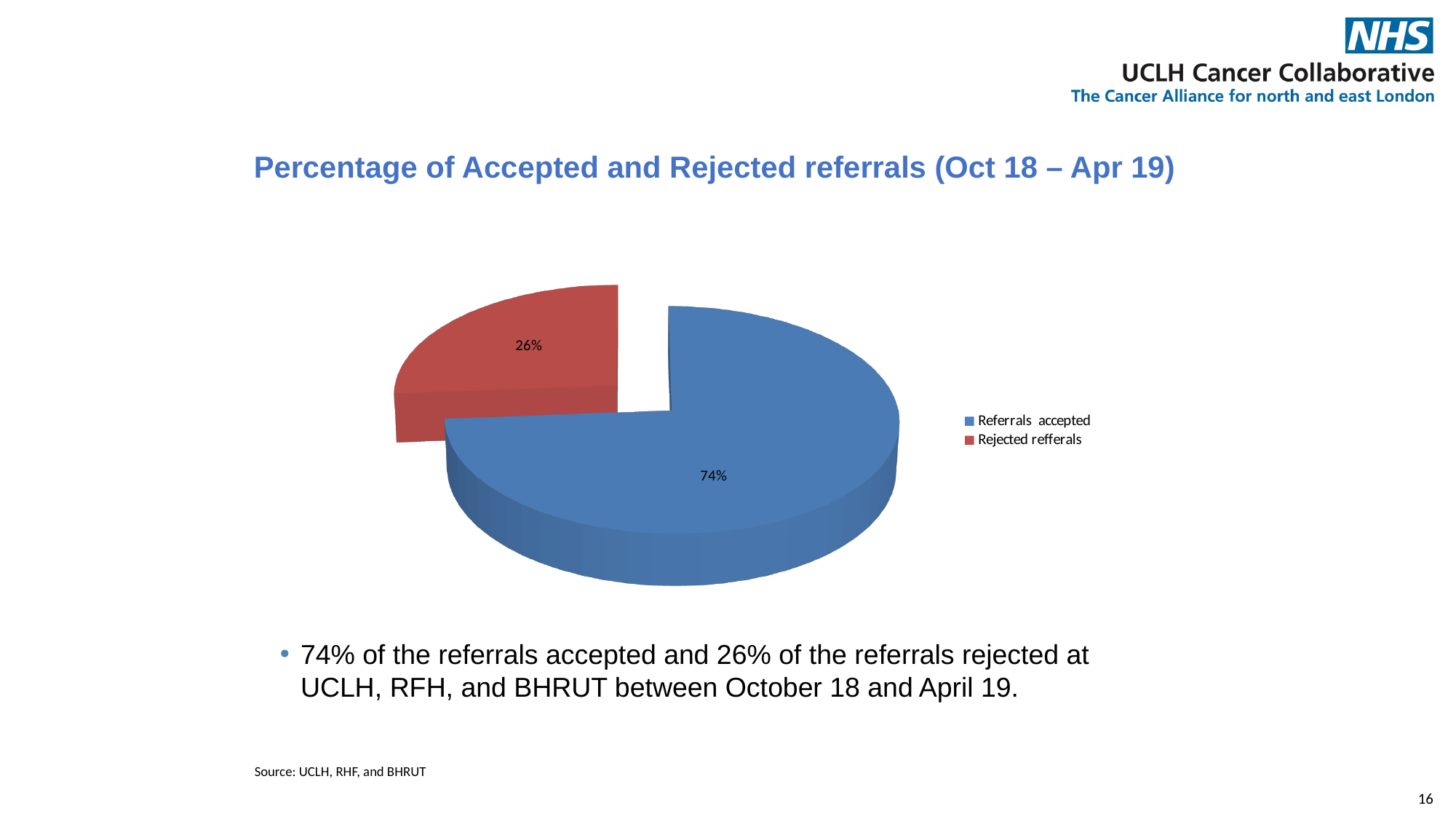
Which slice of the pie chart is the largest? Referrals accepted How many slices does the pie chart have? 2 What share of the pie does the rejected referrals slice represent? 26% What type of chart is shown on the slide? Pie chart Which slice of the pie chart is the smallest? Rejected refferals What percentage of referrals were rejected according to the pie chart? 26% What is the title of the chart on the slide? Percentage of Accepted and Rejected referrals (Oct 18 – Apr 19) What colour is the slice for accepted referrals? Blue What percentage of referrals were accepted according to the pie chart? 74% How many entries does the chart legend list? 2 Which is larger: the share of accepted referrals or the share of rejected referrals? Referrals accepted What is the difference in percentage points between accepted and rejected referrals? 48